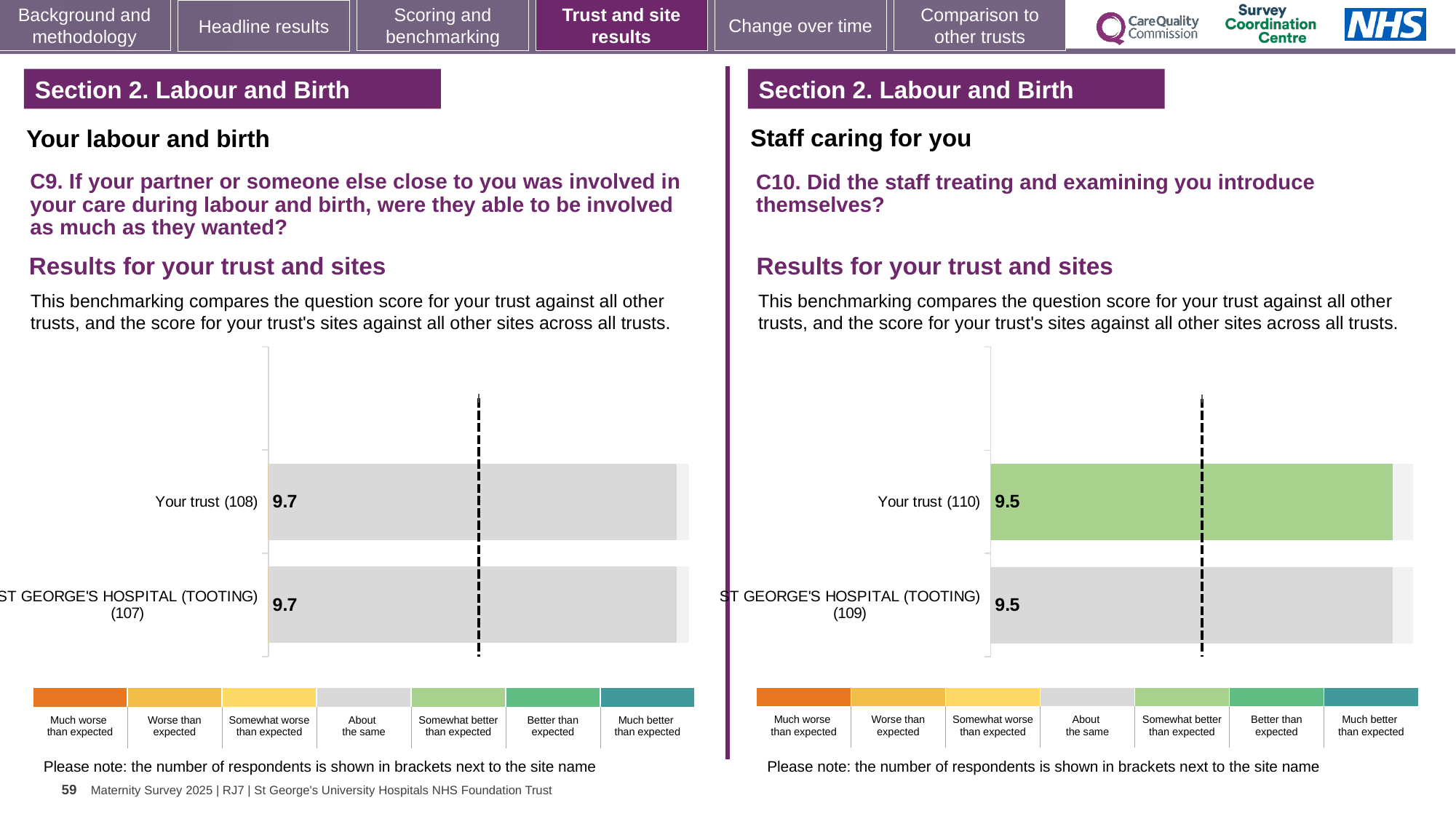
In the right chart (C10), what is the difference between the Your trust score and the St George's Hospital (Tooting) score? 0 How many bars are plotted in the left chart (C9)? 2 In the left chart (C9), what is the score for Your trust? 9.7 What type of chart is used for the C9 results on the left? Bar chart In the right chart (C10), how many respondents are shown in brackets for Your trust? 110 How many bars are plotted in the right chart (C10)? 2 In the right chart (C10), what is the score for St George's Hospital (Tooting)? 9.5 In the left chart (C9), how many respondents are shown in brackets for St George's Hospital (Tooting)? 107 In the right chart (C10), what is the score for Your trust? 9.5 In the left chart (C9), what is the difference between the Your trust score and the St George's Hospital (Tooting) score? 0 In the right chart (C10), which benchmark category does the green colour of the Your trust bar correspond to in the legend? Somewhat better than expected In the left chart (C9), what is the score for St George's Hospital (Tooting)? 9.7